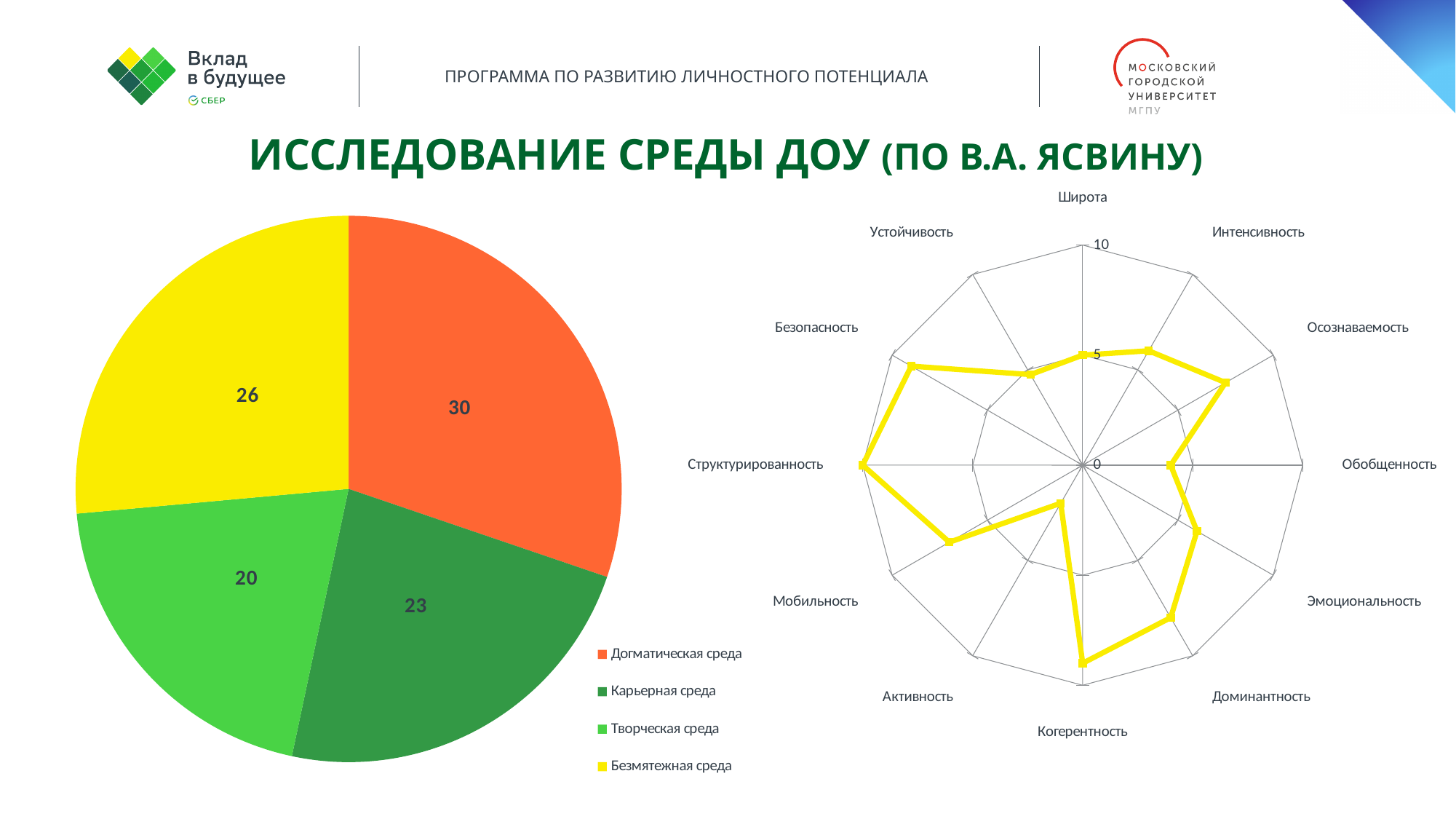
On the radar chart on the right, which category has the highest value? Структурированность On the pie chart on the left, which is larger: Безмятежная среда or Карьерная среда? Безмятежная среда On the radar chart on the right, is the value for Обобщенность greater or less than 5? less On the pie chart on the left, what is the difference between the values for Догматическая среда and Карьерная среда? 7 On the pie chart on the left, which colour represents Карьерная среда? Dark green What type of chart is shown on the left of the slide? Pie chart On the pie chart on the left, which category has the smallest value? Творческая среда On the radar chart on the right, is the value for Когерентность greater or less than 5? greater On the pie chart on the left, what is the value for Догматическая среда? 30 On the pie chart on the left, what is the value for Безмятежная среда? 26 How many slices does the pie chart on the left have? 4 On the pie chart on the left, which category has the largest value? Догматическая среда